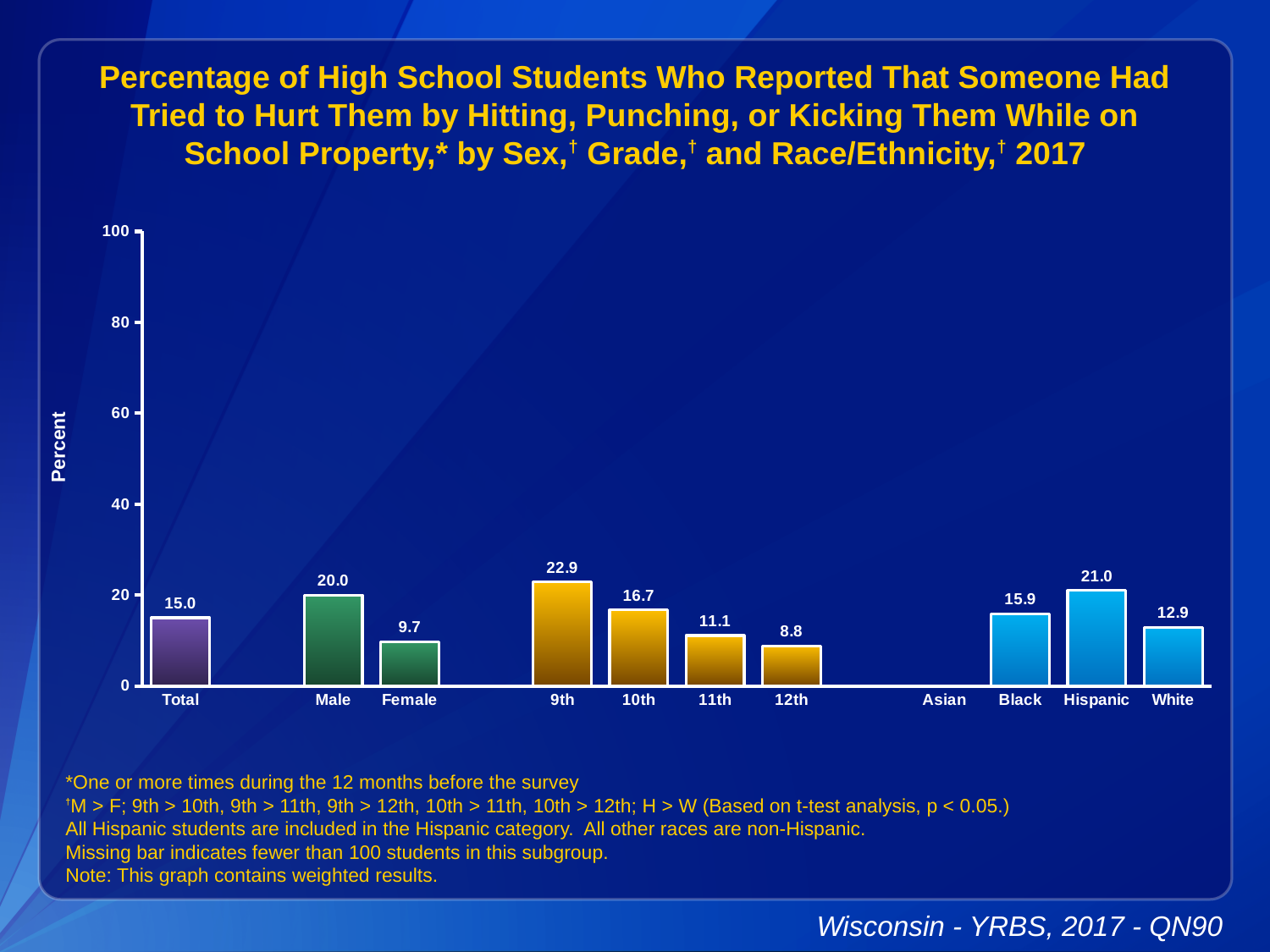
What is the value for Total? 15.0 What is the difference between the 9th and 12th grade values? 14.1 What is the value for Hispanic? 21.0 Which category with a bar has the lowest value? 12th Is the value for 10th grade greater or less than 20? less Which category label has no bar shown? Asian What is the value for Male? 20.0 What is the difference between the Male and Female values? 10.3 Which is larger, the value for Black or the value for White? Black Which category has the highest value? 9th What is the value for 9th grade? 22.9 What kind of chart is shown? bar chart